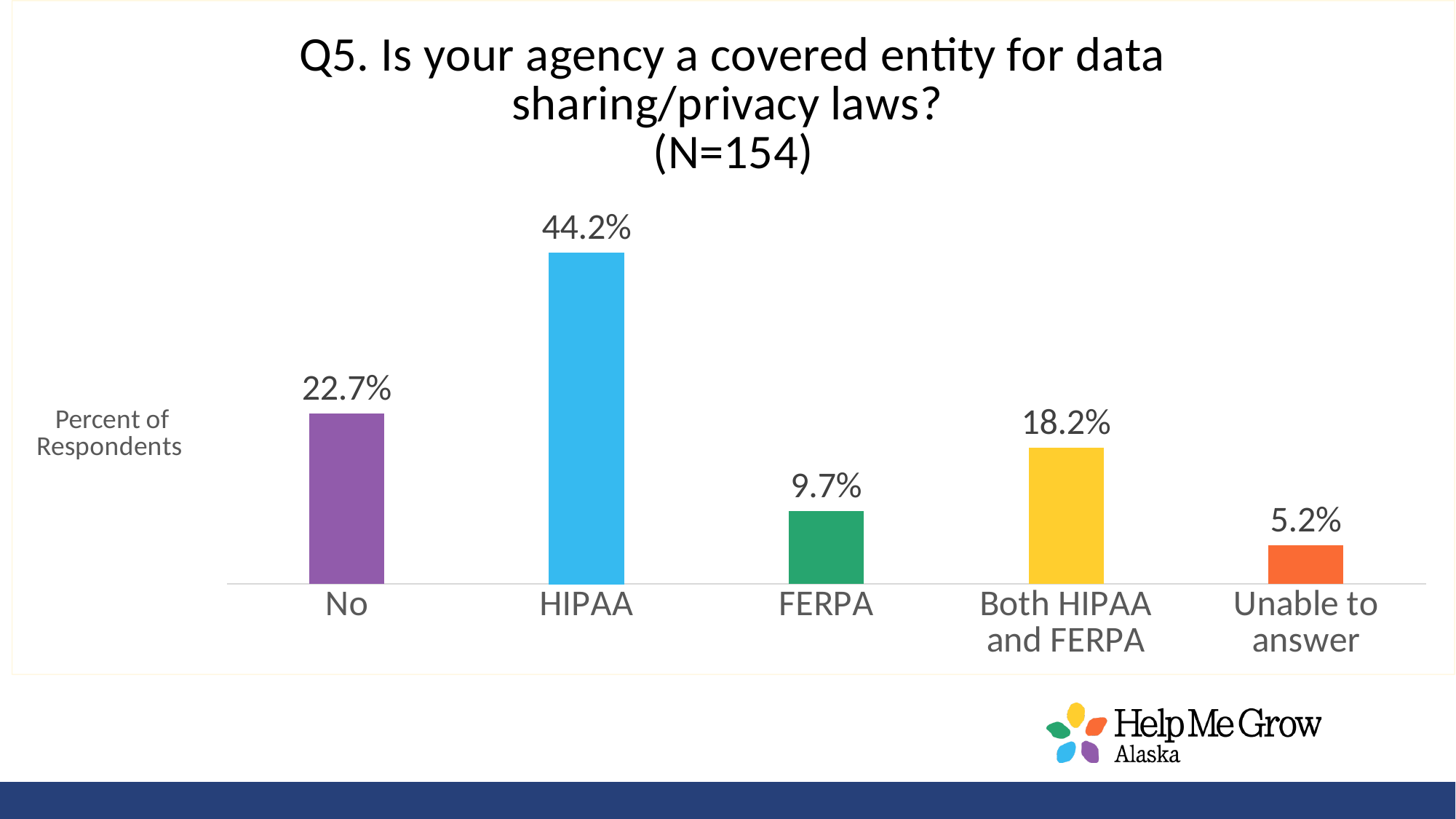
Which category has the lowest percentage of respondents? Unable to answer What percentage of respondents answered No? 22.7% What percentage of respondents were Unable to answer? 5.2% What percentage of respondents answered Both HIPAA and FERPA? 18.2% What percentage of respondents answered HIPAA? 44.2% How many categories are shown on the x axis? 5 Which category has the highest percentage of respondents? HIPAA Which is larger, the value for No or the value for Both HIPAA and FERPA? No What kind of chart is shown on the slide? Bar chart What percentage of respondents answered FERPA? 9.7% What is the difference in percentage points between HIPAA and No? 21.5 What is the sample size (N) given in the chart title? 154